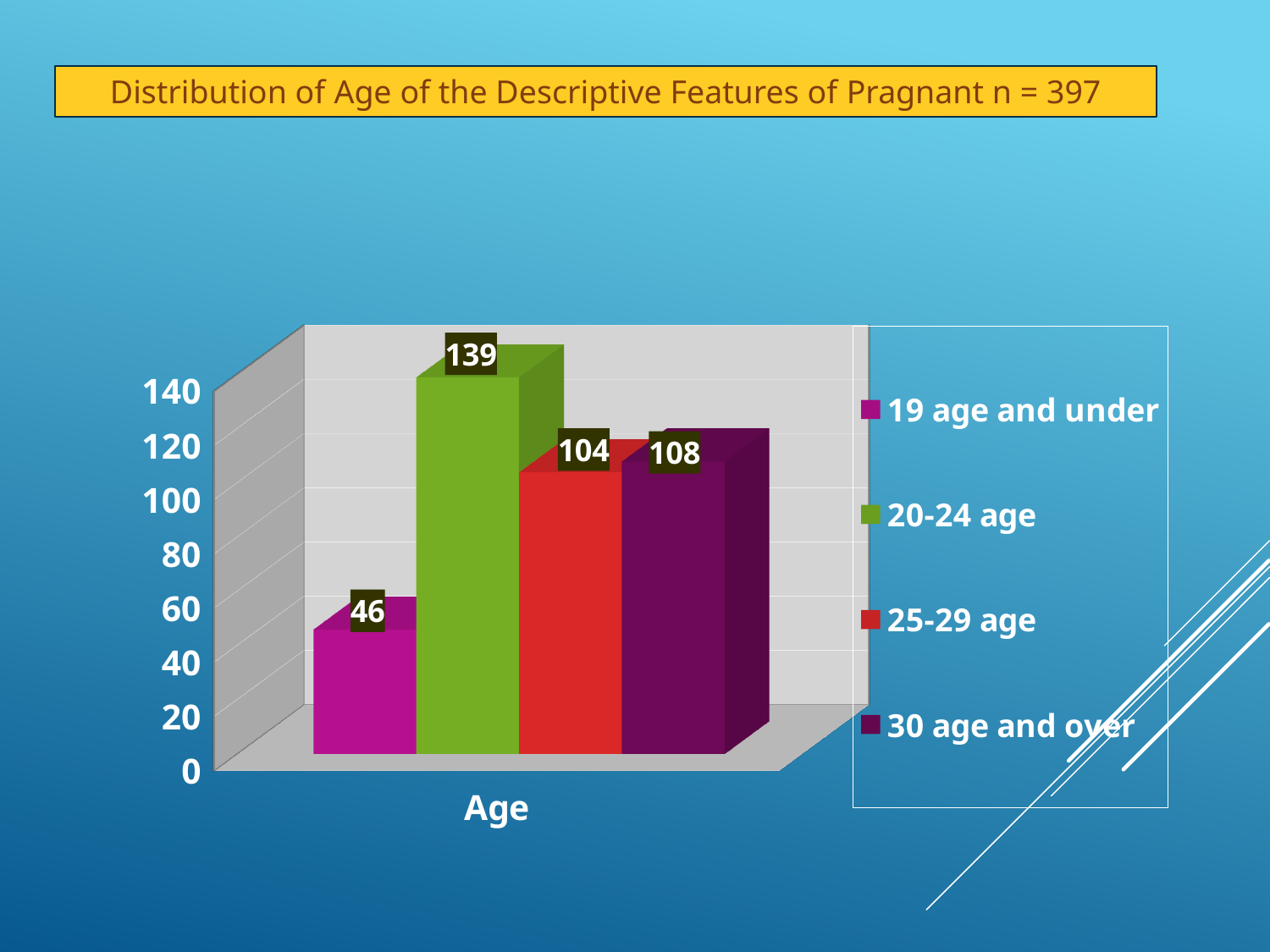
What is the value for the 30 age and over group? 108 What is the difference between the values for the 20-24 age group and the 19 age and under group? 93 Which age group has the lowest value? 19 age and under What is the value for the 19 age and under group? 46 Which is larger, the value for the 20-24 age group or the 25-29 age group? 20-24 age Which age group has the highest value? 20-24 age What is the value for the 25-29 age group? 104 What is the title of the chart on the slide? Distribution of Age of the Descriptive Features of Pragnant n = 397 How many series does the legend list? 4 What is the value for the 20-24 age group? 139 What is the difference between the values for the 30 age and over group and the 25-29 age group? 4 What kind of chart is shown on the slide? Bar chart